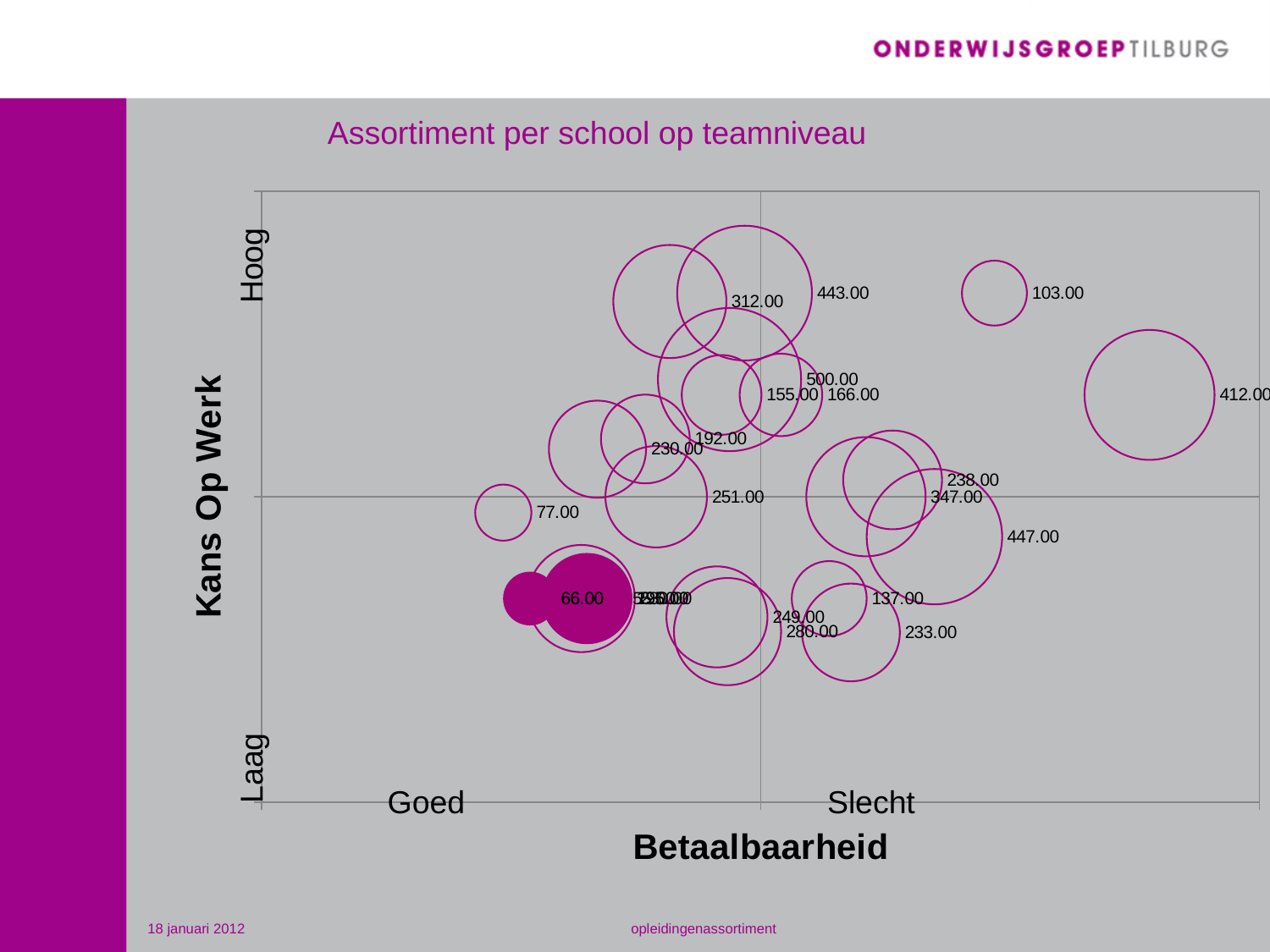
Which labeled bubble value is larger, 238.00 or 233.00? 238.00 What is the difference between the bubble values labeled 447.00 and 347.00? 100.00 What is the label of the horizontal axis of the chart? Betaalbaarheid What is the title of the chart? Assortiment per school op teamniveau What is the smallest value printed as a bubble label on the chart? 66.00 What is the difference between the bubble values labeled 280.00 and 249.00? 31.00 What kind of chart is shown on the slide? bubble chart Which labeled bubble value is larger, 443.00 or 412.00? 443.00 Is the bubble value labeled 77.00 greater or less than 100? less What is the difference between the largest labeled bubble value (500.00) and the smallest labeled bubble value (66.00)? 434.00 What is the largest value printed as a bubble label on the chart? 500.00 Which labeled bubble value is larger, 103.00 or 137.00? 137.00